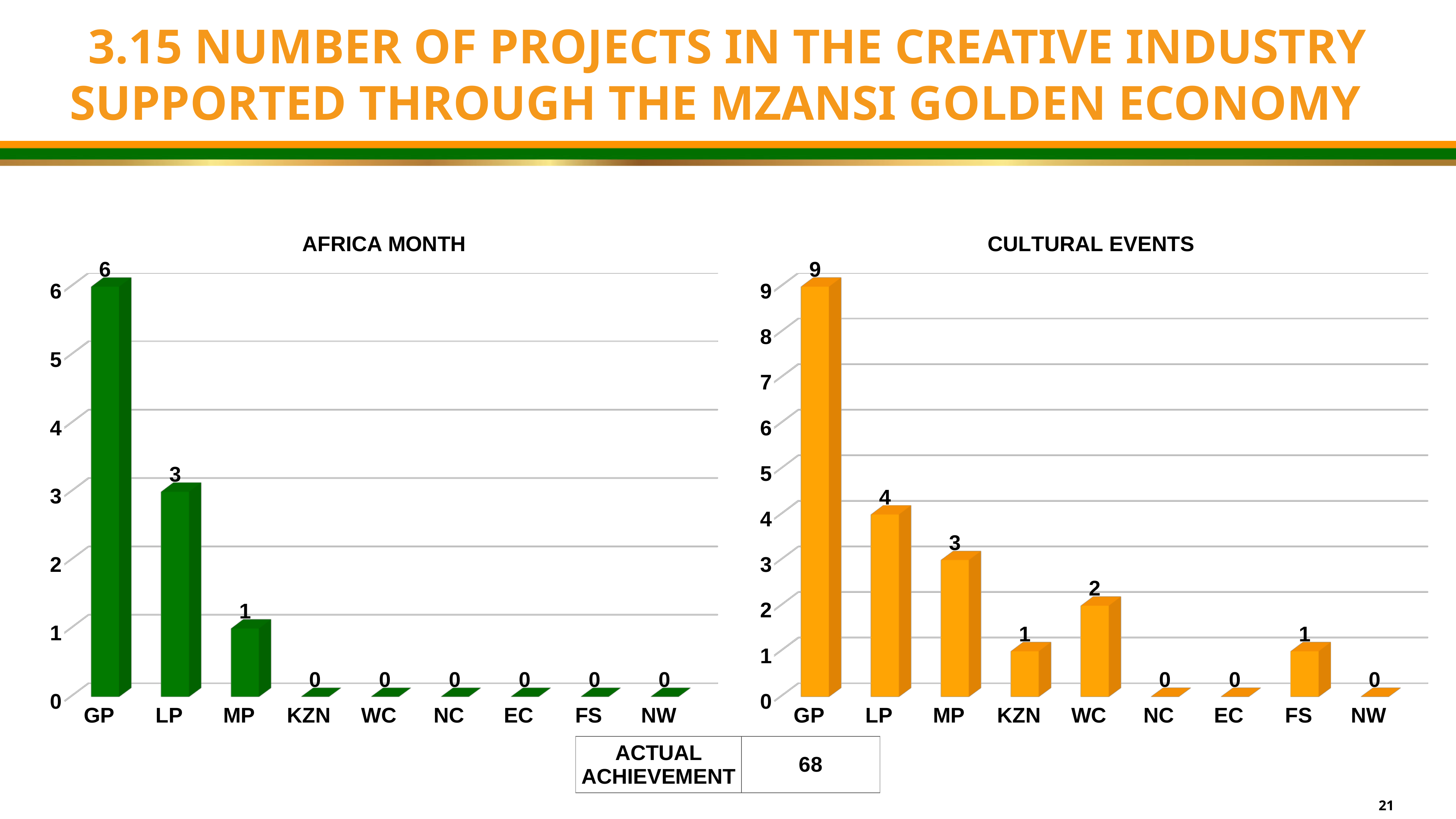
What colour are the bars in the AFRICA MONTH chart? Green In the AFRICA MONTH chart, what is the value for GP? 6 What kind of chart is the CULTURAL EVENTS chart? Bar chart In the CULTURAL EVENTS chart, what is the value for WC? 2 In the CULTURAL EVENTS chart, what is the difference between the values for GP and LP? 5 How many provinces are shown on the x axis of the AFRICA MONTH chart? 9 In the CULTURAL EVENTS chart, what is the value for FS? 1 In the AFRICA MONTH chart, which province has the highest value? GP In the AFRICA MONTH chart, what is the value for LP? 3 In the CULTURAL EVENTS chart, which province has the highest value? GP In the CULTURAL EVENTS chart, which is larger, the value for MP or the value for KZN? MP In the AFRICA MONTH chart, what is the difference between the values for GP and MP? 5